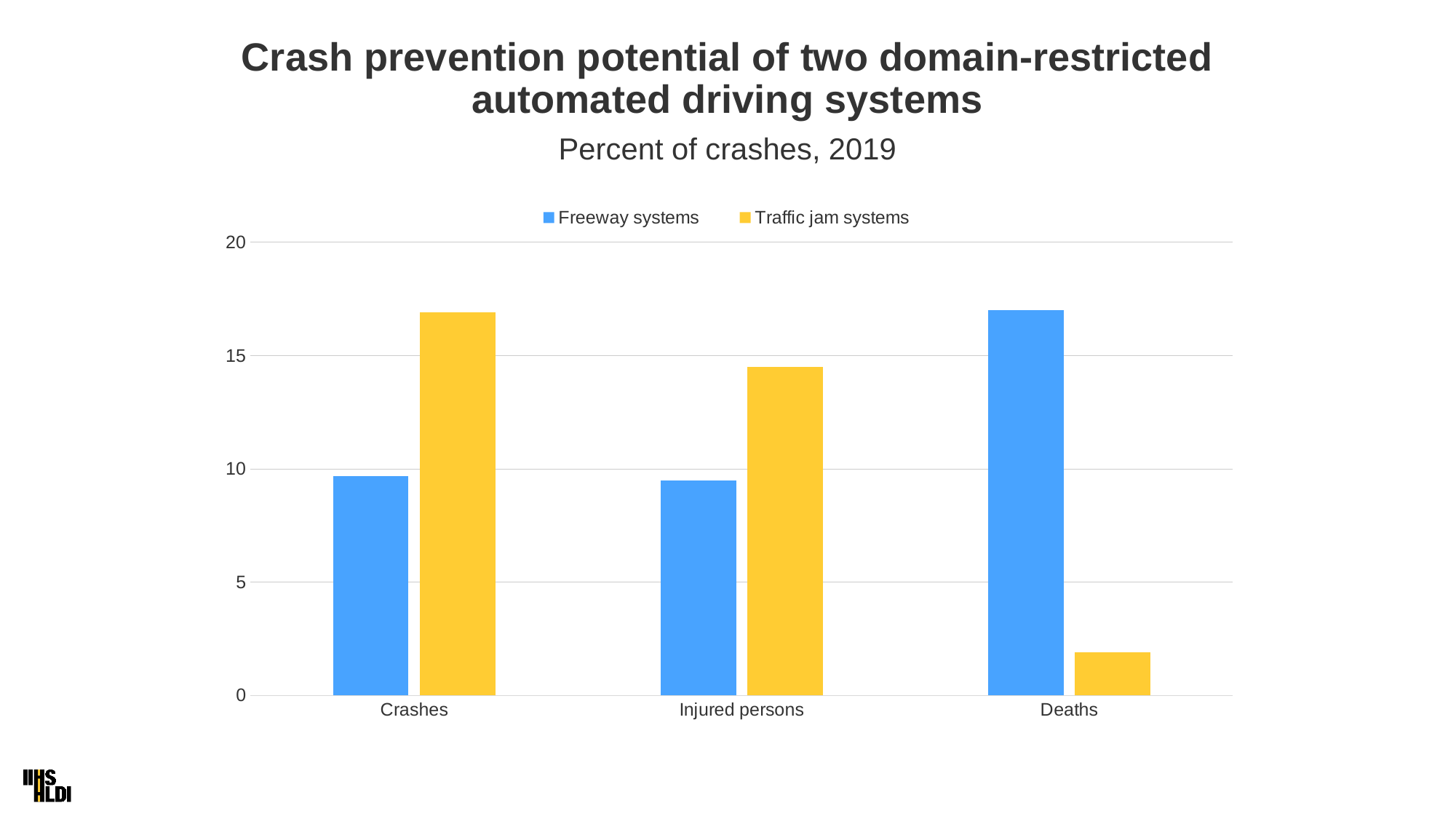
Is the value for Freeway systems in the Crashes category greater or less than 10? less Is the value for Freeway systems in the Deaths category greater or less than 15? greater How many series does the legend list? 2 Which category has the lowest value for Traffic jam systems? Deaths For Injured persons, which series has the larger value, Freeway systems or Traffic jam systems? Traffic jam systems What is the subtitle of the chart? Percent of crashes, 2019 What type of chart is shown on the slide? bar chart How many categories are shown on the x axis? 3 Is the value for Traffic jam systems in the Crashes category greater or less than 15? greater Which category has the highest value for Freeway systems? Deaths Which category has the highest value for Traffic jam systems? Crashes